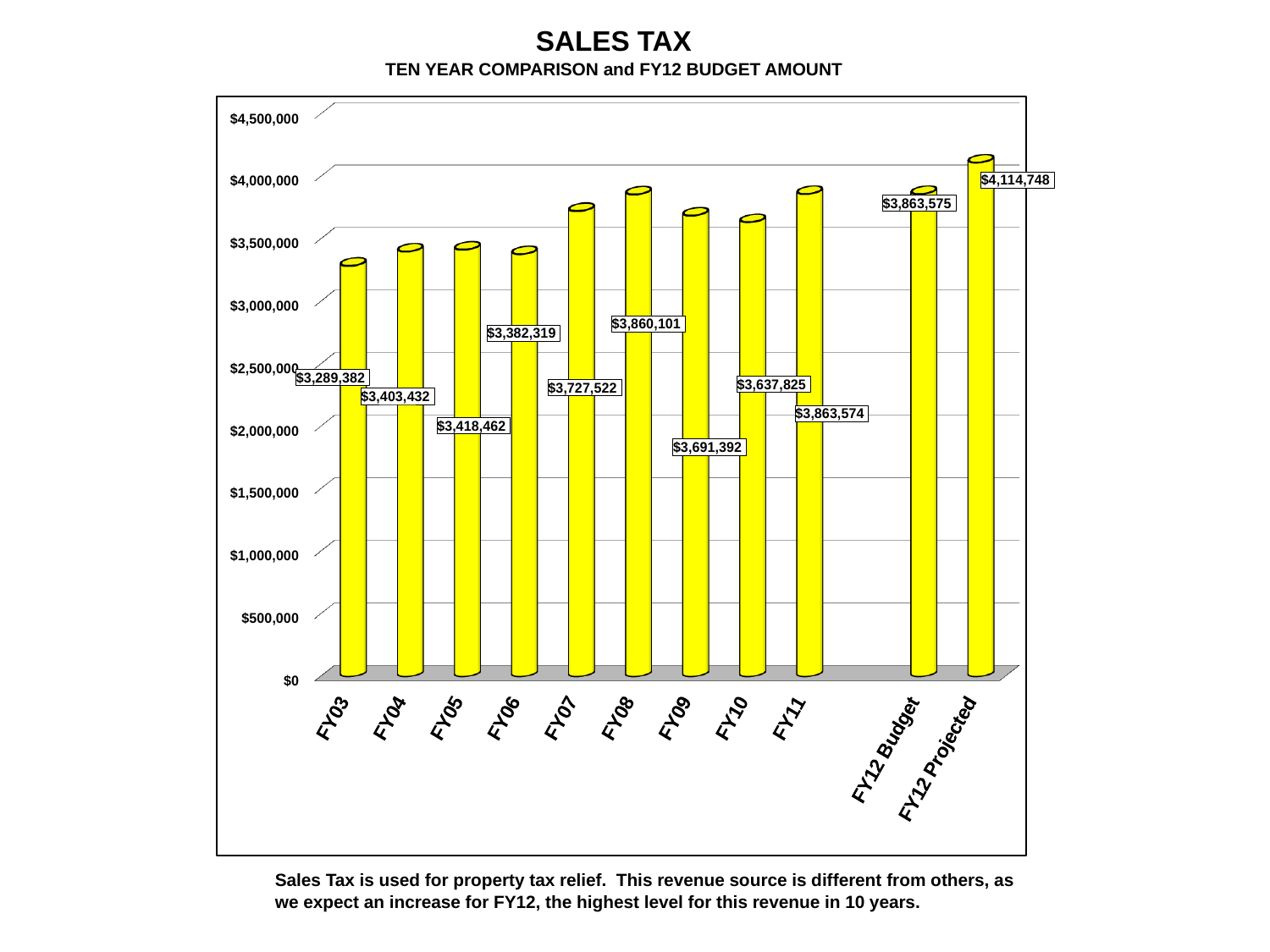
What is the main title of the chart? SALES TAX What is the sales tax value for FY03? $3,289,382 Which category has the lowest sales tax value? FY03 What is the FY12 Budget sales tax amount? $3,863,575 What is the difference between the FY12 Projected value and the FY11 value? $251,174 What is the sales tax value for FY07? $3,727,522 Is the value for FY06 greater or less than $3,500,000? less Which is larger, the sales tax value for FY08 or for FY09? FY08 How many bars are shown in the chart? 11 What kind of chart is shown on the slide? Bar chart Which category has the highest sales tax value? FY12 Projected What is the FY12 Projected sales tax amount? $4,114,748